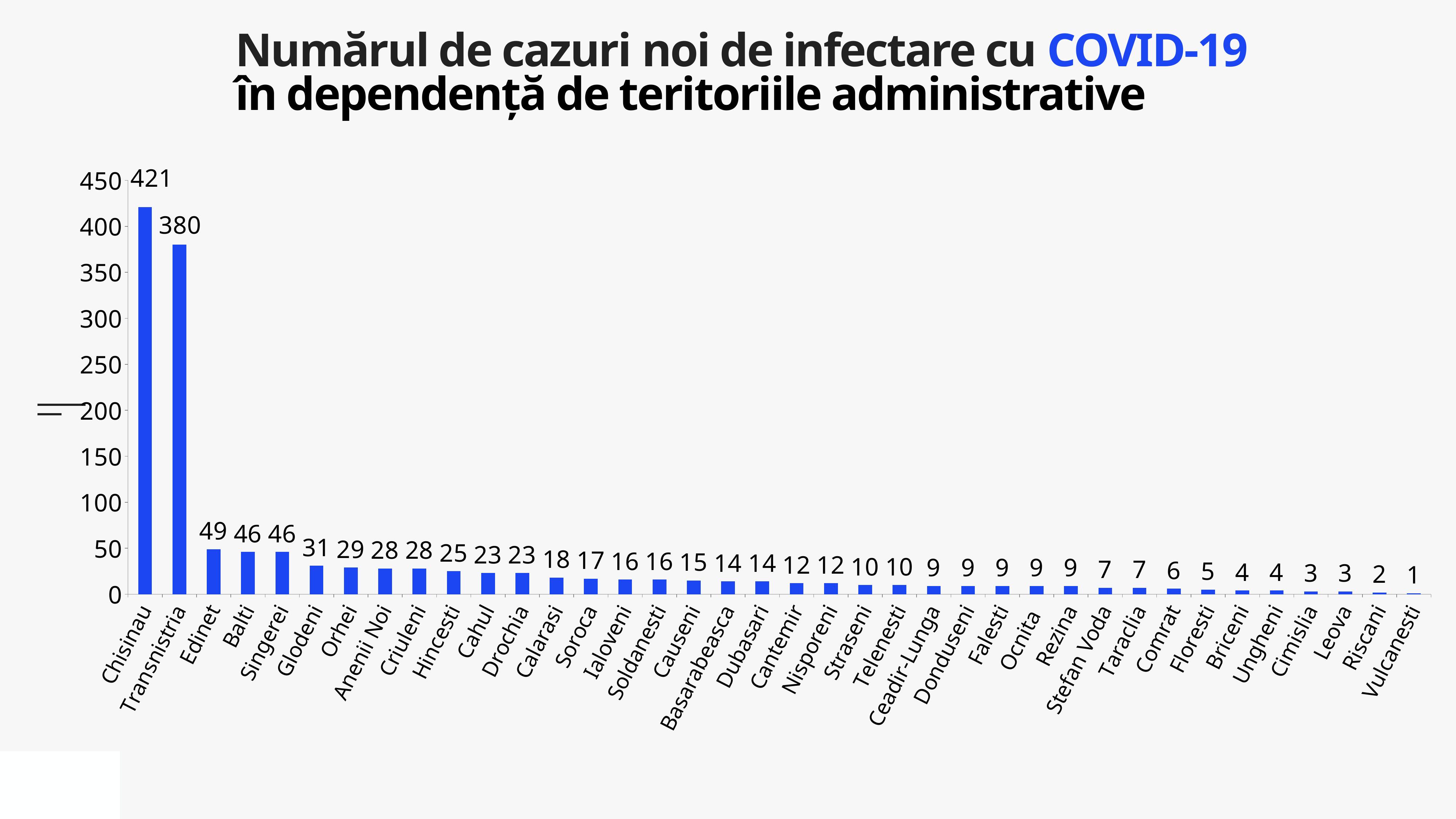
What is the value for Chisinau? 421 What is the value for Transnistria? 380 Which is larger, the value for Glodeni or the value for Hincesti? Glodeni What is the difference between the values for Chisinau and Transnistria? 41 What kind of chart is shown on the slide? bar chart Is the value for Transnistria greater or less than 350? greater Which category has the highest value? Chisinau How many categories are shown on the x axis? 38 Which category has the lowest value? Vulcanesti What is the value for Edinet? 49 What is the value for Cahul? 23 What is the value for Orhei? 29